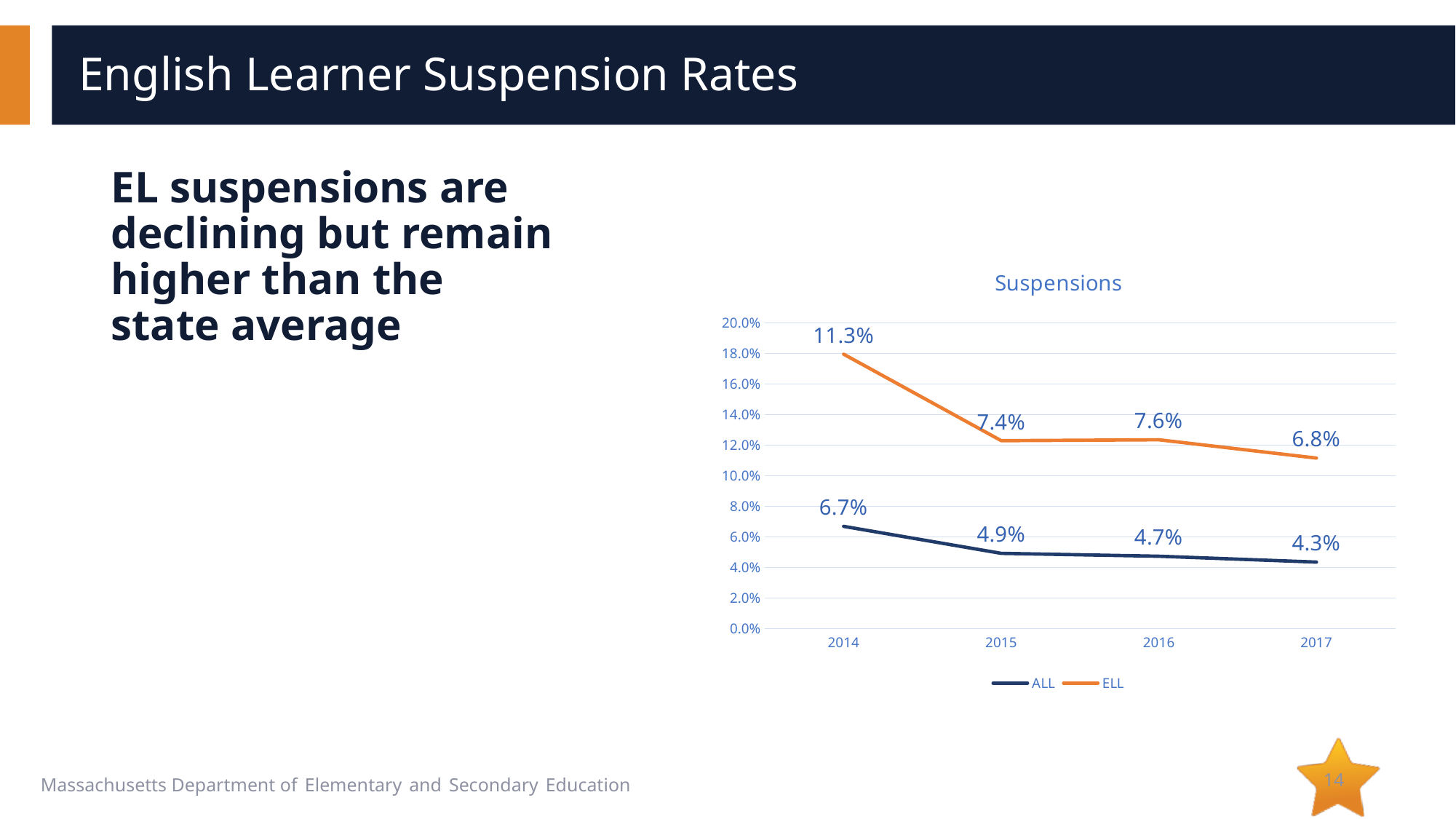
What is the ALL suspension rate in 2017? 4.3% Which series has the higher suspension rate in 2017, ALL or ELL? ELL How many series does the legend list? 2 What is the ELL suspension rate in 2016? 7.6% Does the ALL suspension rate rise or fall from 2014 to 2017? Fall How many years are shown on the x axis of the chart? 4 In which year is the ELL suspension rate highest? 2014 What is the difference between the ELL and ALL suspension rates in 2015? 2.5% What type of chart is shown on the slide? Line chart What is the title of the chart? Suspensions What is the ELL suspension rate in 2014? 11.3% In which year is the ALL suspension rate lowest? 2017